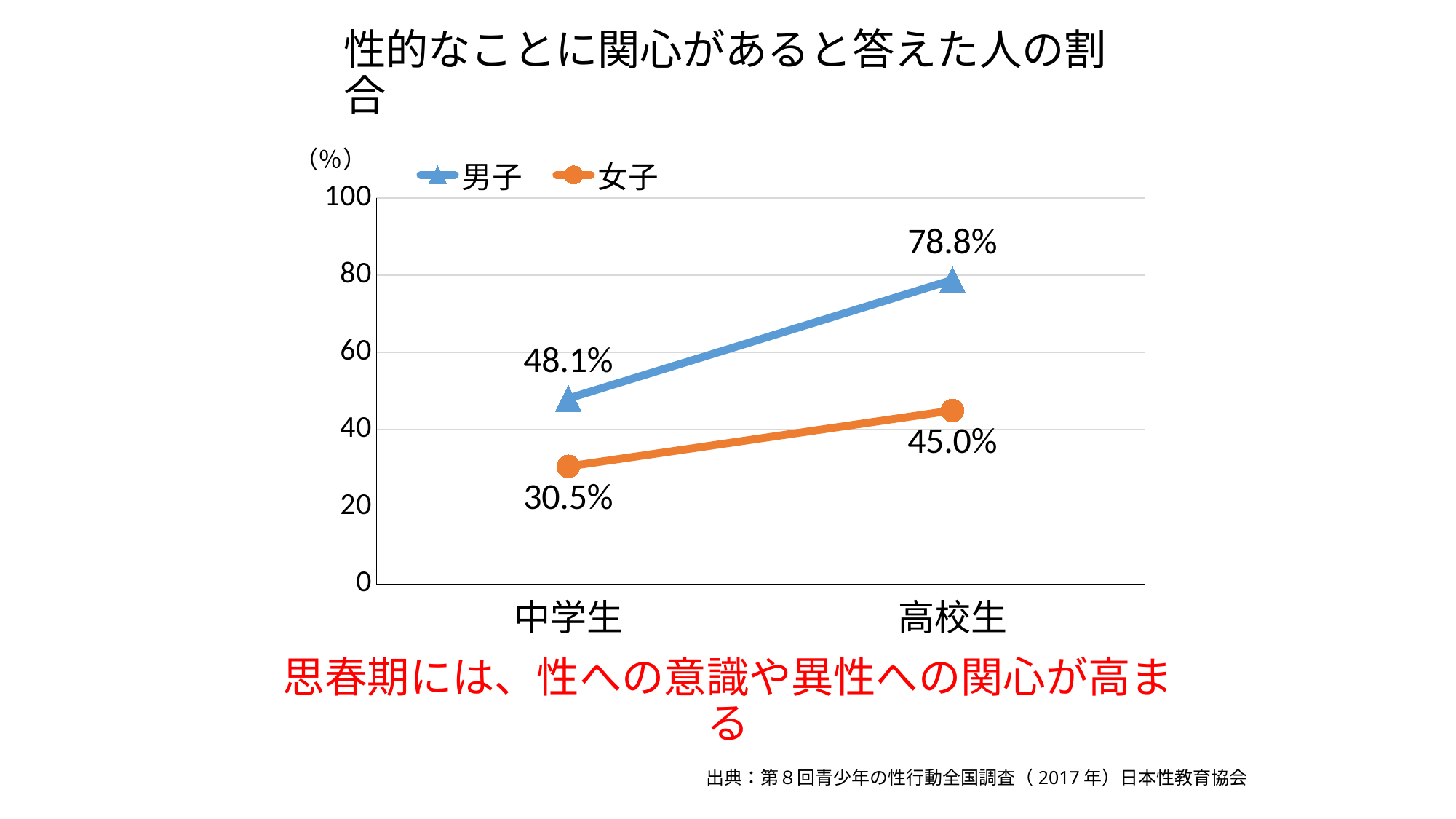
What kind of chart is shown? Line chart How many series does the legend list? 2 Do the 女子 values rise or fall from 中学生 to 高校生? Rise What is the value for 男子 at 中学生? 48.1% Which is larger: 女子 at 高校生 or 男子 at 中学生? 男子 at 中学生 Which series has the highest value at 高校生? 男子 What is the difference between the 男子 values at 高校生 and 中学生? 30.7% What is the difference between 男子 and 女子 at 高校生? 33.8% Which series has the lowest value at 中学生? 女子 What is the value for 女子 at 高校生? 45.0% What is the value for 女子 at 中学生? 30.5% What is the value for 男子 at 高校生? 78.8%